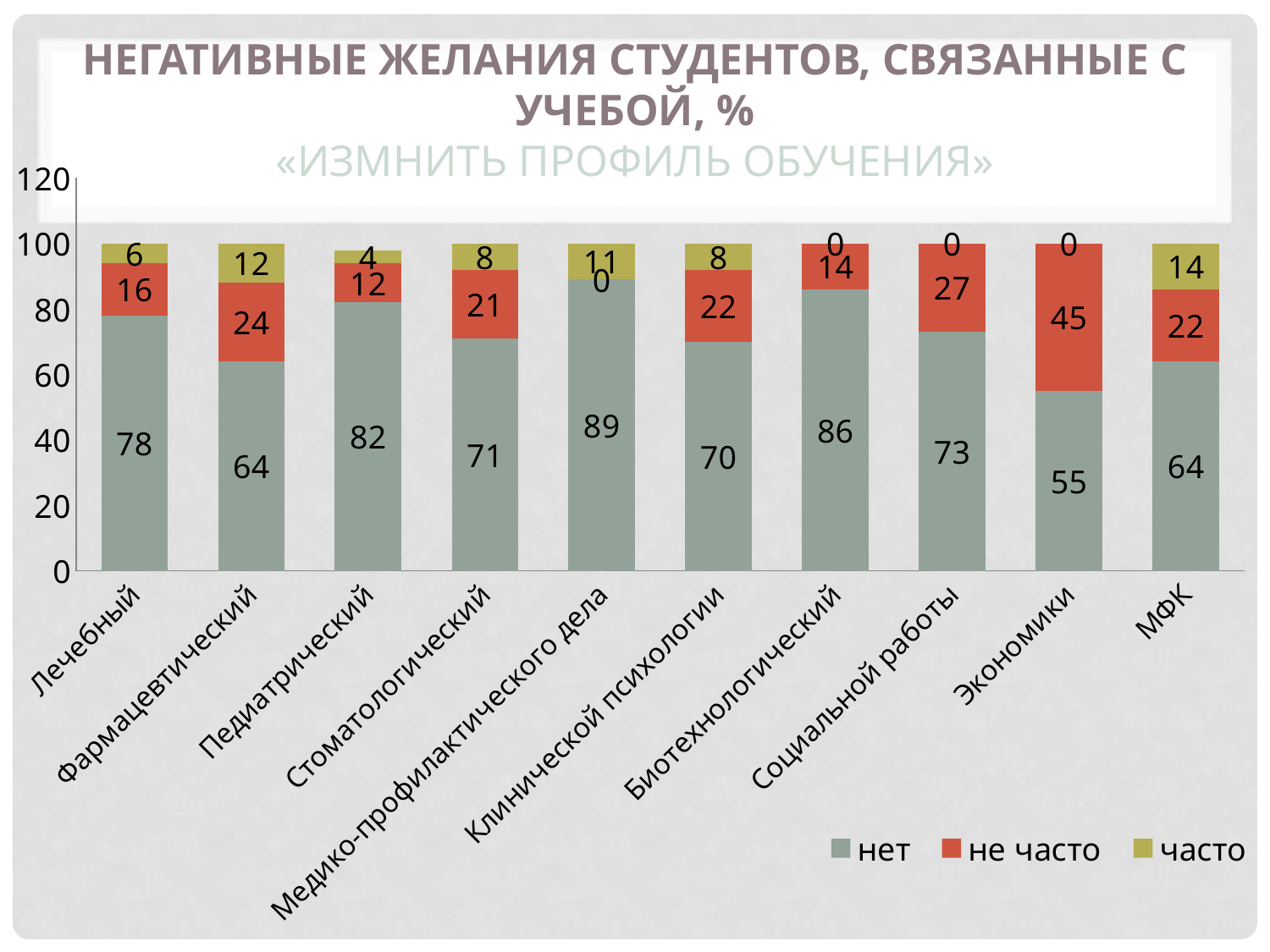
How many categories (faculties) are shown on the x axis? 10 What is the value of the 'не часто' series for Социальной работы? 27 Which is larger: the 'не часто' value for Стоматологический or for Клинической психологии? Клинической психологии What kind of chart is shown on the slide? stacked bar chart Which category has the highest value for the 'не часто' series? Экономики Which category has the highest value for the 'нет' series? Медико-профилактического дела What is the value of the 'часто' series for МФК? 14 What is the difference between the 'нет' values for Педиатрический and Фармацевтический? 18 Which category has the lowest value for the 'нет' series? Экономики What is the total of the stacked bar for Педиатрический? 98 What is the value of the 'нет' series for Экономики? 55 How many series does the legend list? 3